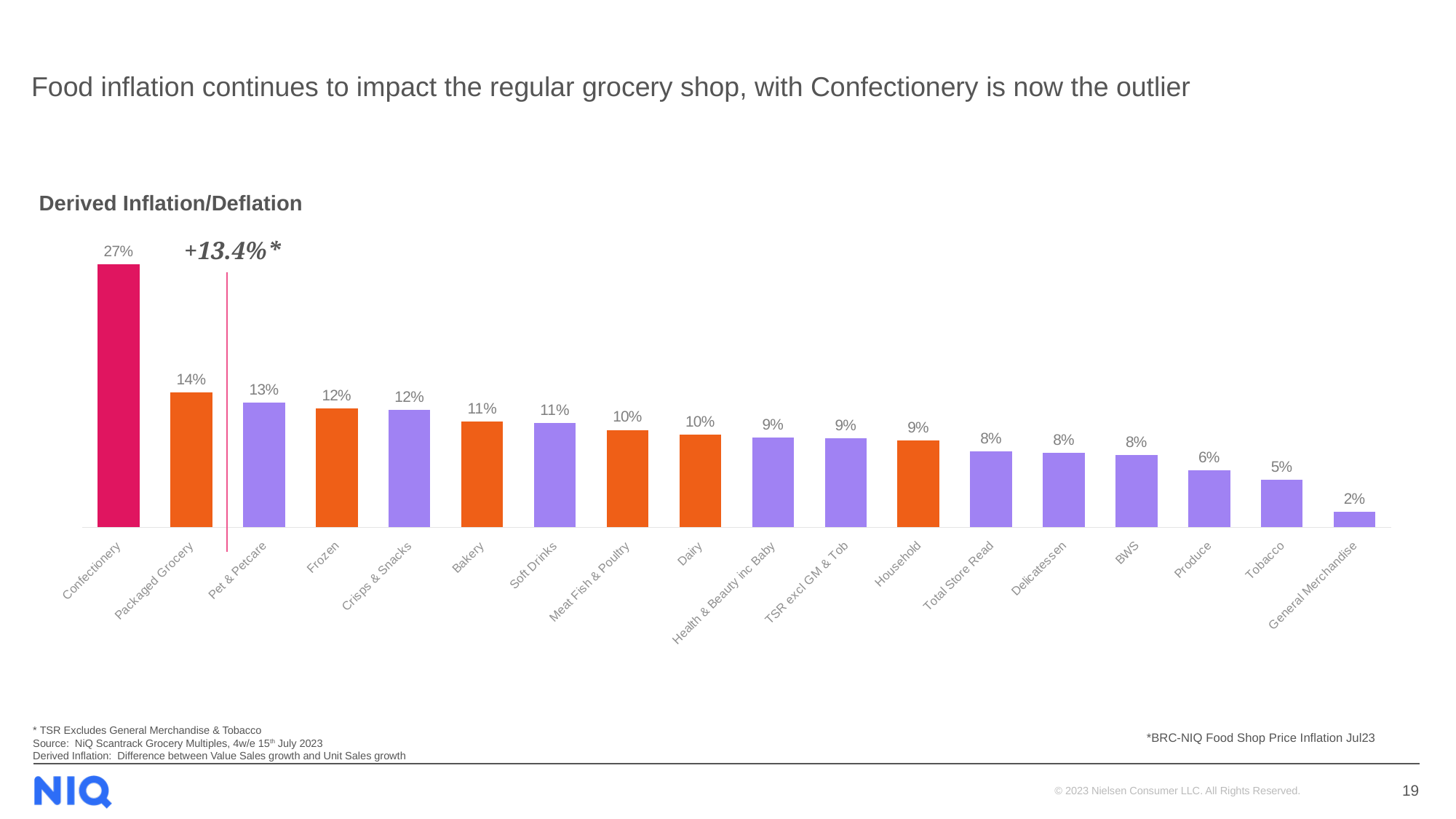
What is the title of the chart? Derived Inflation/Deflation What is the derived inflation value for Confectionery? 27% What is the derived inflation value for Household? 9% What type of chart is shown on the slide? Bar chart Do the values rise or fall moving from left to right along the x axis? Fall What is the derived inflation value for General Merchandise? 2% How many categories are shown in the chart? 18 What is the difference between the derived inflation for Confectionery and Packaged Grocery? 13% Which category has the lowest derived inflation? General Merchandise What is the derived inflation value for Packaged Grocery? 14% Which has a higher derived inflation value, Frozen or Produce? Frozen Which category has the highest derived inflation? Confectionery